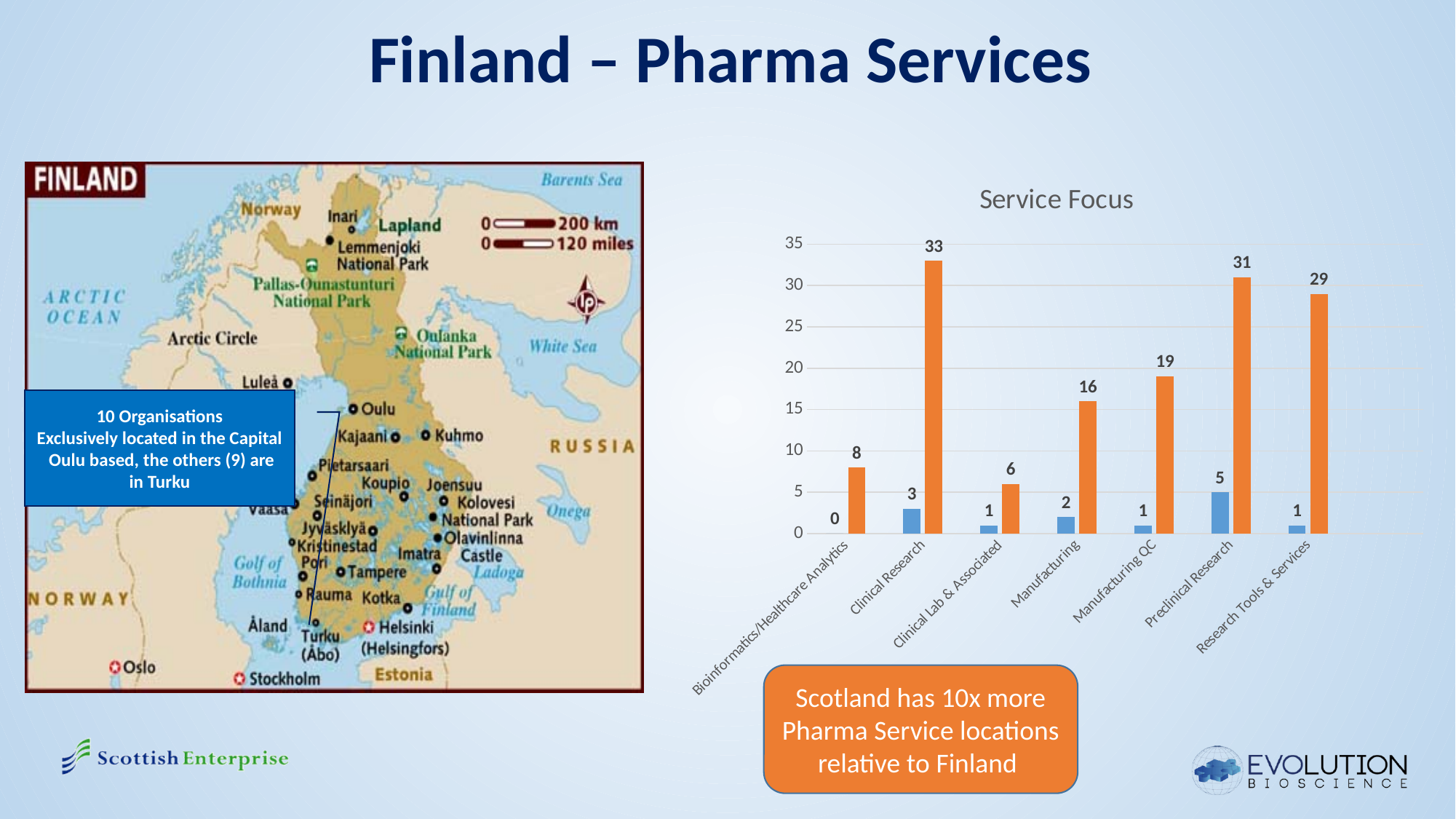
What is the difference between the orange bars for Clinical Research and Preclinical Research in the Service Focus chart? 2 In the Service Focus chart, which has a larger orange bar: Manufacturing or Research Tools & Services? Research Tools & Services Which category has the lowest orange bar in the Service Focus chart? Clinical Lab & Associated What type of chart is the Service Focus chart? Bar chart What is the value of the blue bar for Preclinical Research in the Service Focus chart? 5 What is the value of the blue bar for Bioinformatics/Healthcare Analytics in the Service Focus chart? 0 What is the title of the chart on the slide? Service Focus Which category has the highest orange bar in the Service Focus chart? Clinical Research What is the value of the orange bar for Clinical Research in the Service Focus chart? 33 How many categories are shown on the x axis of the Service Focus chart? 7 What is the difference between the orange and blue bars for Manufacturing in the Service Focus chart? 14 What is the value of the orange bar for Manufacturing QC in the Service Focus chart? 19